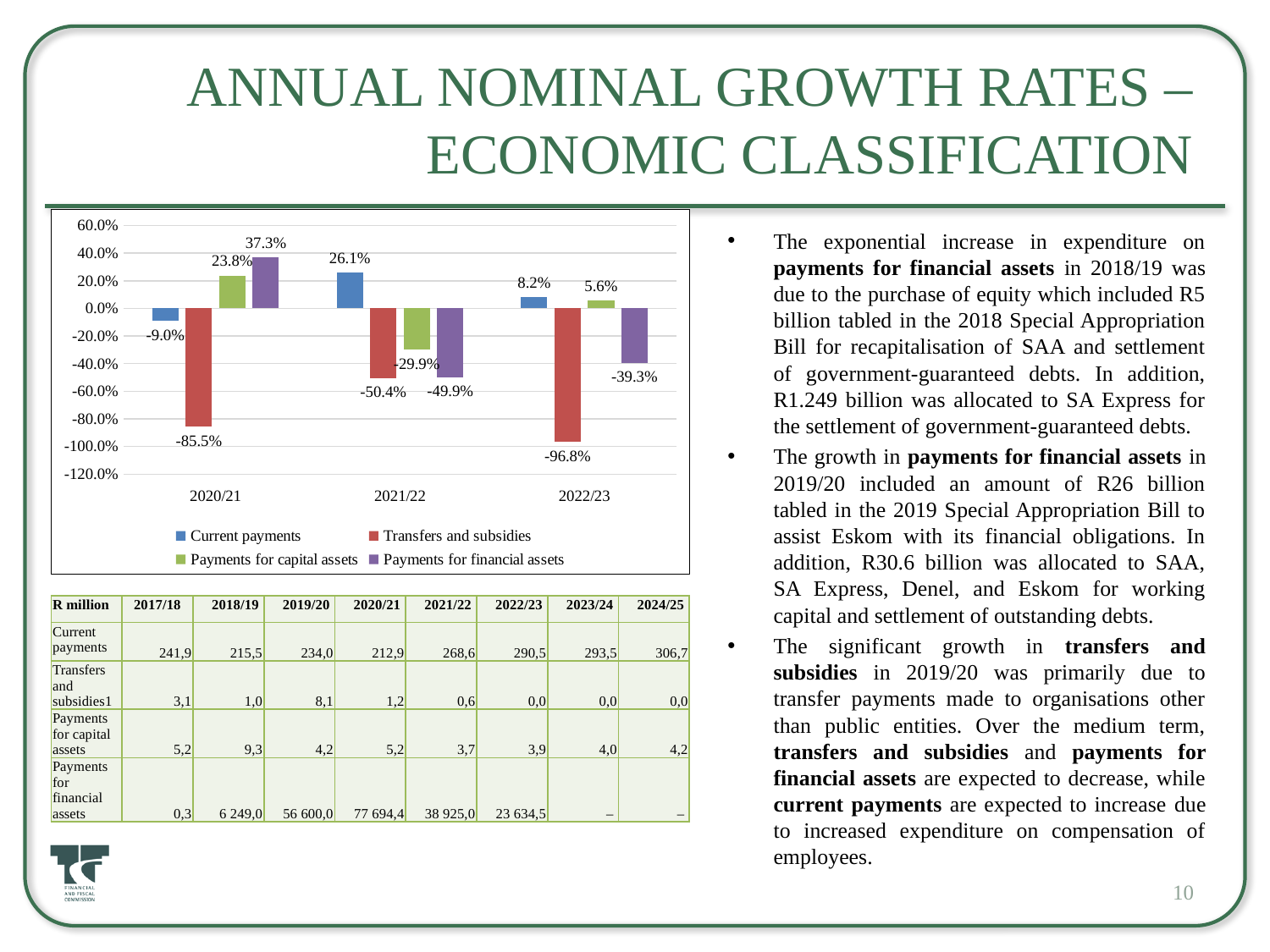
What is the annual nominal growth rate for Payments for financial assets in 2020/21? 37.3% How does the growth rate for Transfers and subsidies change from 2021/22 to 2022/23? It falls Which is larger in 2022/23: the growth rate for Current payments or for Payments for capital assets? Current payments How many year categories are shown on the x axis? 3 What is the growth rate for Transfers and subsidies in 2022/23? -96.8% What is the growth rate for Payments for capital assets in 2021/22? -29.9% What is the difference between the growth rates for Payments for financial assets and Payments for capital assets in 2020/21? 13.5 percentage points What is the growth rate for Current payments in 2021/22? 26.1% Which series has the highest growth rate in 2021/22? Current payments Which series has the lowest growth rate in 2020/21? Transfers and subsidies How many series does the legend list? 4 What type of chart is shown on the slide? Bar chart